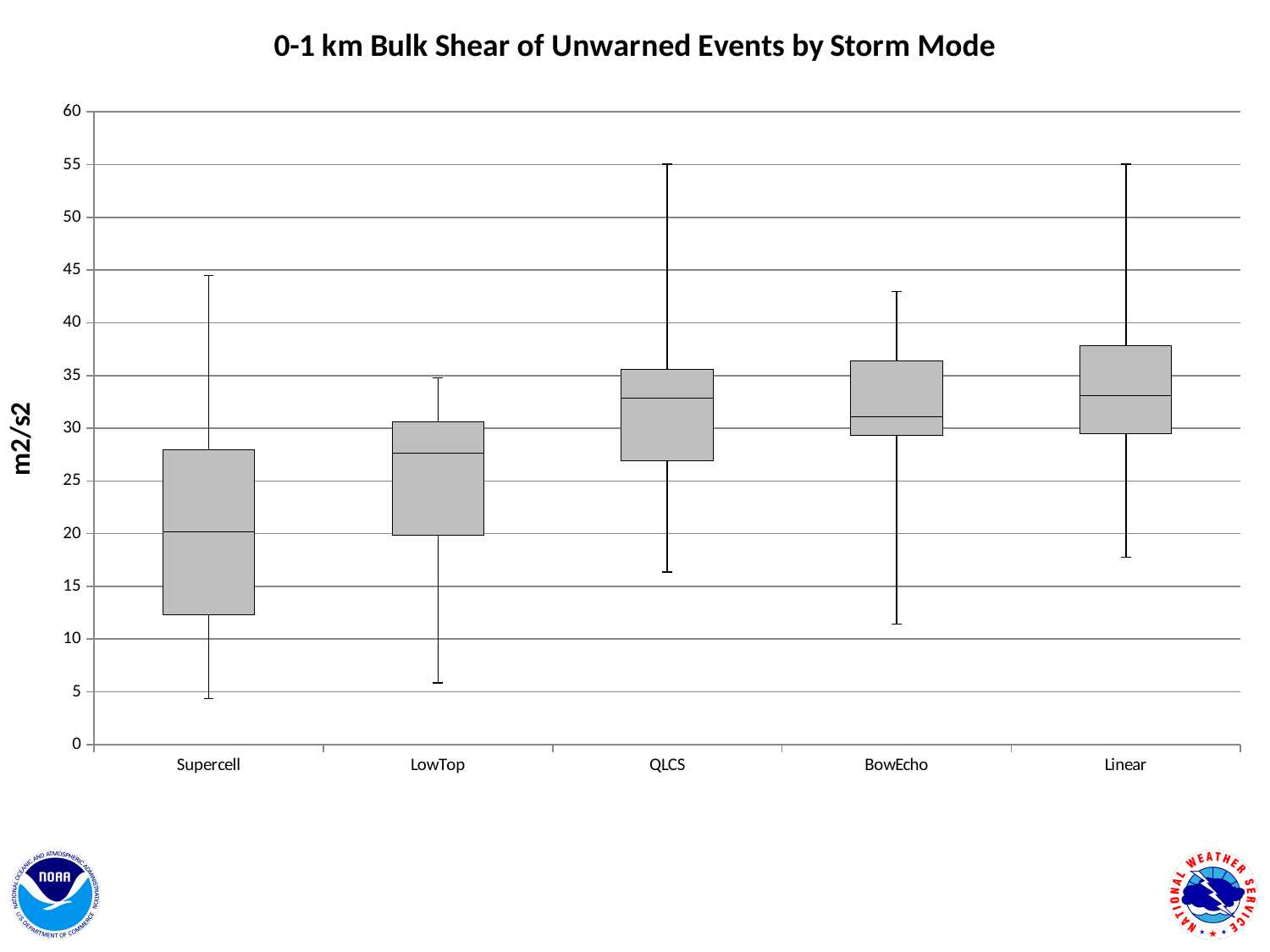
How many storm mode categories are shown on the x axis? 5 Which has the larger median value, Supercell or LowTop? LowTop Is the upper whisker for LowTop greater or less than 30? greater Is the median value for Supercell greater or less than 25? less Is the lower whisker for QLCS greater or less than 20? less What is the title of the chart? 0-1 km Bulk Shear of Unwarned Events by Storm Mode Which has the higher lower whisker, BowEcho or Linear? Linear What is the label on the vertical axis? m2/s2 Which storm mode has the lowest median value? Supercell What kind of chart is shown on the slide? Box plot